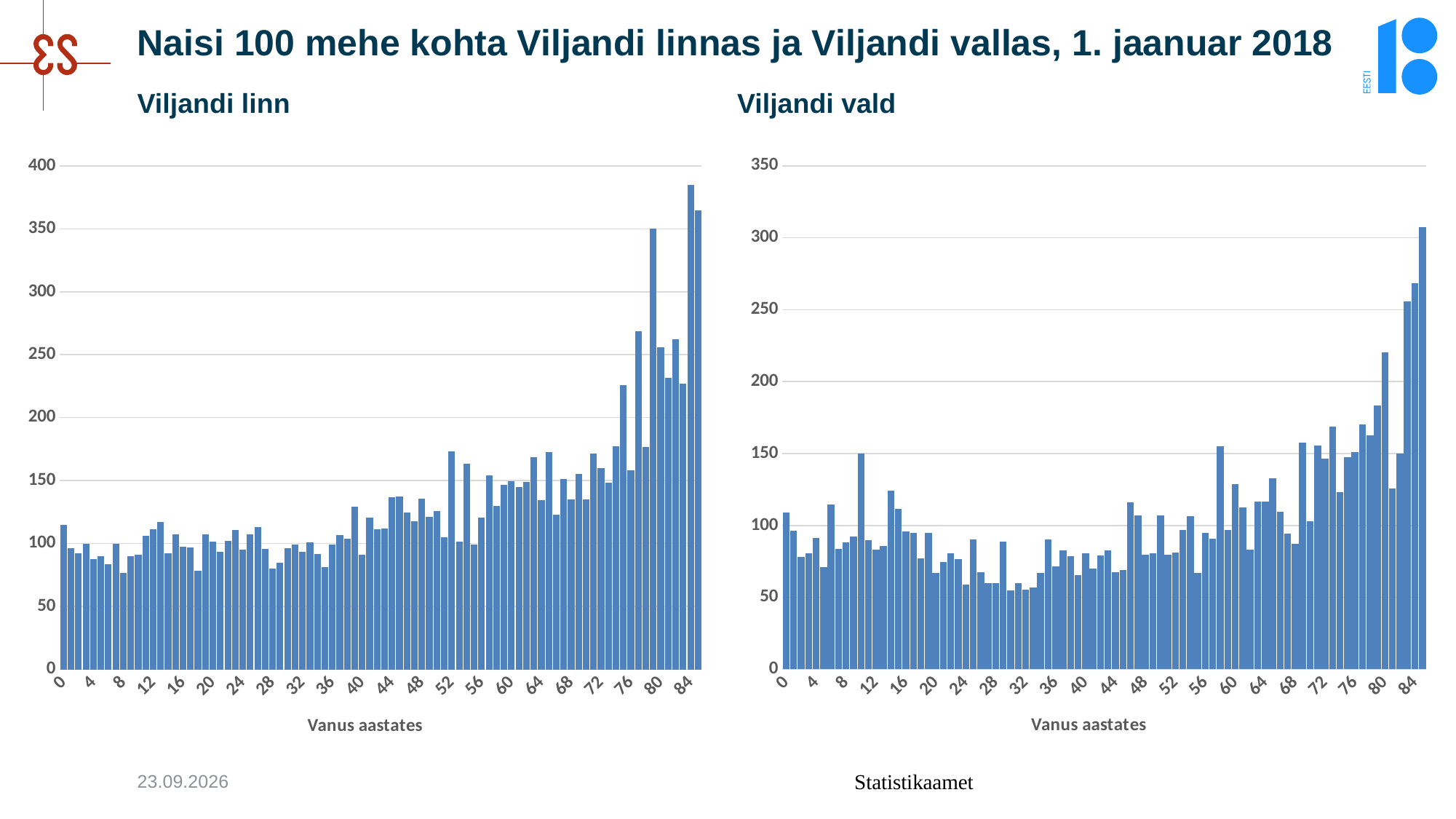
In the Viljandi linn chart, do the values generally rise or fall as age increases along the x axis? rise What kind of chart is the Viljandi linn chart? bar chart In the Viljandi linn chart, is the value for age 52 greater or less than 150? greater In the Viljandi vald chart, do the values generally rise or fall as age increases along the x axis? rise In the Viljandi vald chart, is the value for age 32 greater or less than 100? less In the Viljandi vald chart, is the value for age 84 greater or less than 250? greater What kind of chart is the Viljandi vald chart? bar chart What is the highest value shown on the y axis of the Viljandi linn chart? 400 What is the x-axis title of the Viljandi vald chart? Vanus aastates Which chart has the higher maximum bar, Viljandi linn or Viljandi vald? Viljandi linn